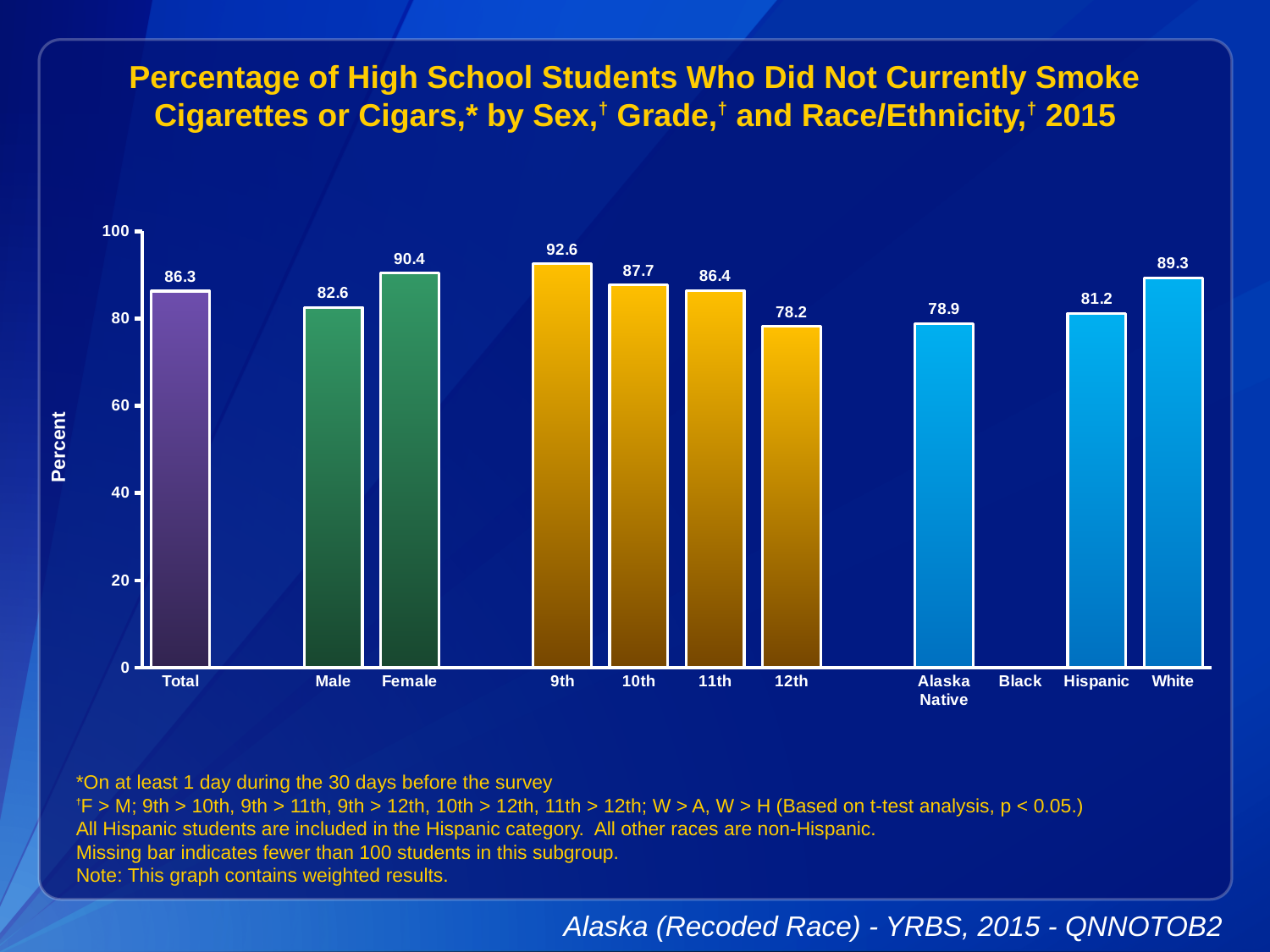
Which category with a plotted bar has the lowest value? 12th What is the value for Female? 90.4 What kind of chart is shown on the slide? bar chart Which is larger, the value for 10th grade or the value for 11th grade? 10th Do the values fall or rise from 9th grade to 12th grade? fall What is the value for Alaska Native? 78.9 What is the difference between the Female and Male values? 7.8 Is the value for Total greater or less than 80? greater Which category on the x axis has no bar plotted? Black What is the value for 12th grade? 78.2 What is the difference between the White and Hispanic values? 8.1 Which category has the highest bar? 9th